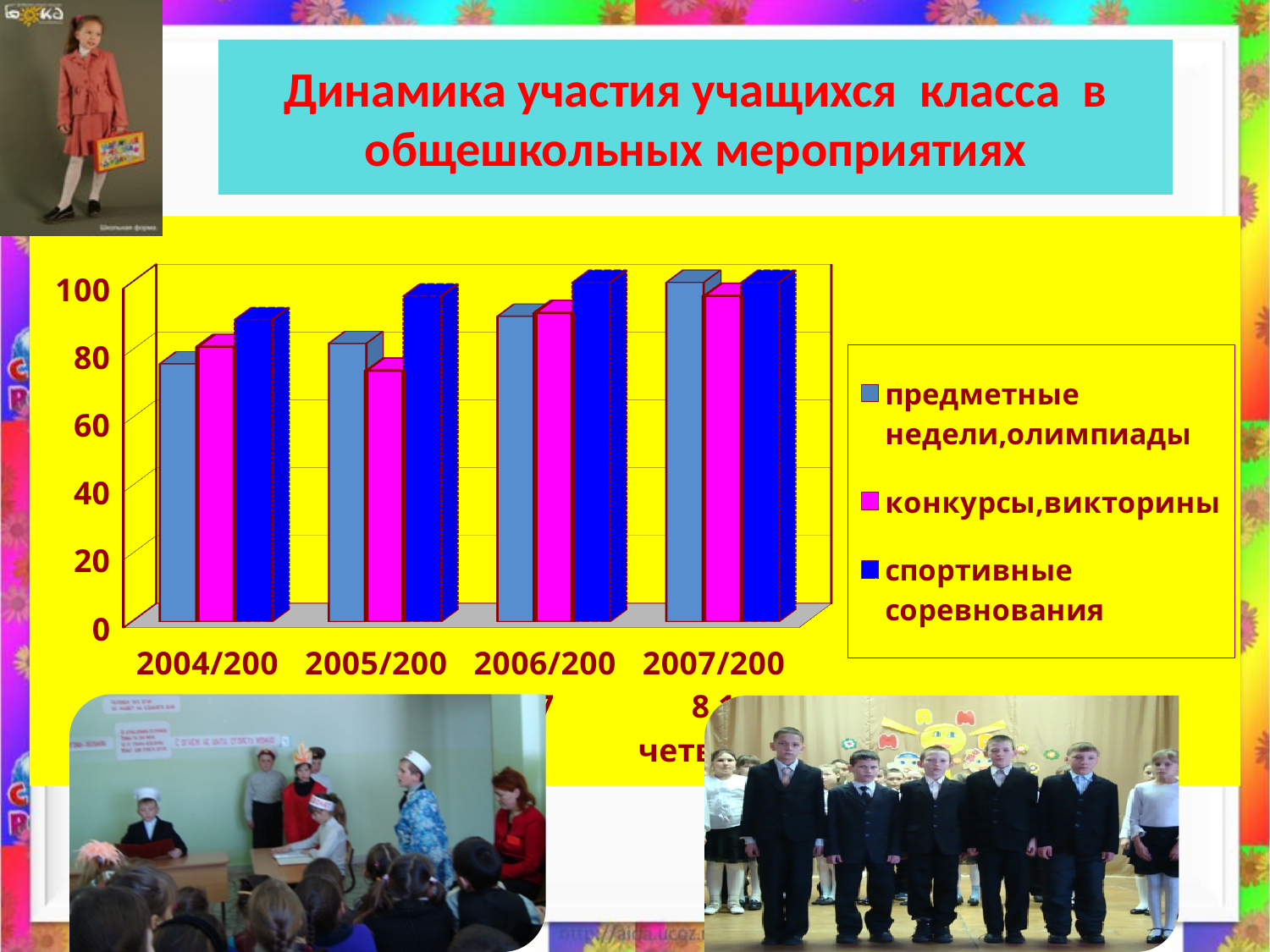
Which series has the lowest value in 2005/200...? конкурсы,викторины What is the title of the chart? Динамика участия учащихся класса в общешкольных мероприятиях Do the values for предметные недели,олимпиады rise or fall from 2004/200... to 2007/200...? rise What colour represents спортивные соревнования in the legend? dark blue Is the value for спортивные соревнования in 2004/200... greater or less than 80? greater How many year categories are shown along the x axis? 4 Is the value for предметные недели,олимпиады in 2004/200... greater or less than 60? greater How many series does the legend list? 3 Which series has the highest value in 2005/200...? спортивные соревнования Is the value for конкурсы,викторины in 2005/200... greater or less than 80? less In 2004/200..., which is larger: спортивные соревнования or предметные недели,олимпиады? спортивные соревнования What kind of chart is shown on the slide? bar chart